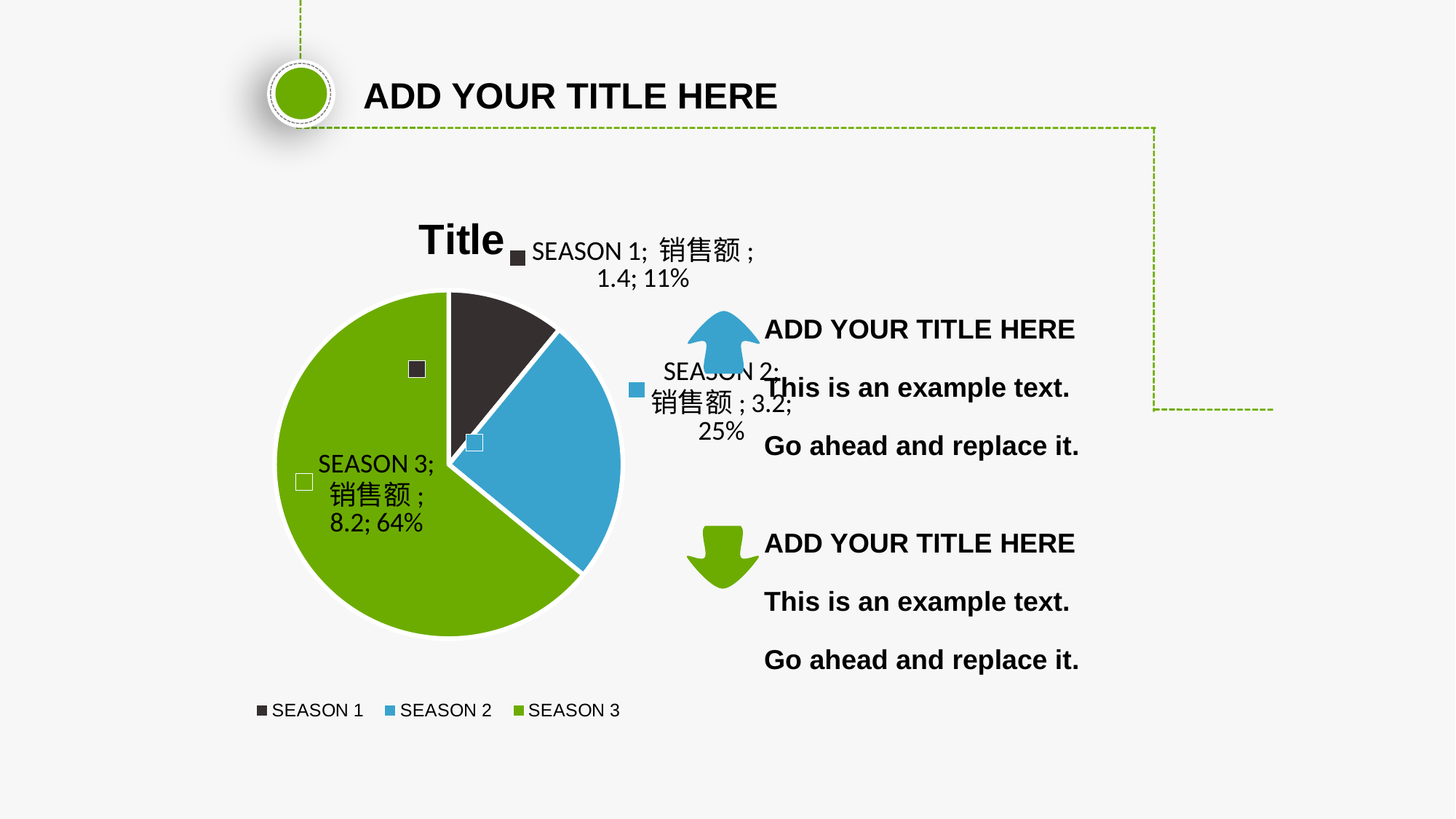
What is the value for SEASON 1 in the pie chart? 1.4 What is the difference between the values for SEASON 3 and SEASON 2? 5.0 Which season has the smallest slice of the pie? SEASON 1 What percentage share of the pie does SEASON 3 have? 64% How many categories does the legend of the pie chart list? 3 What is the value for SEASON 2 in the pie chart? 3.2 What is the value for SEASON 3 in the pie chart? 8.2 What percentage share of the pie does SEASON 1 have? 11% What percentage share of the pie does SEASON 2 have? 25% What type of chart is shown on the slide? pie chart Which is larger, the value for SEASON 2 or SEASON 1? SEASON 2 Which season has the largest slice of the pie? SEASON 3